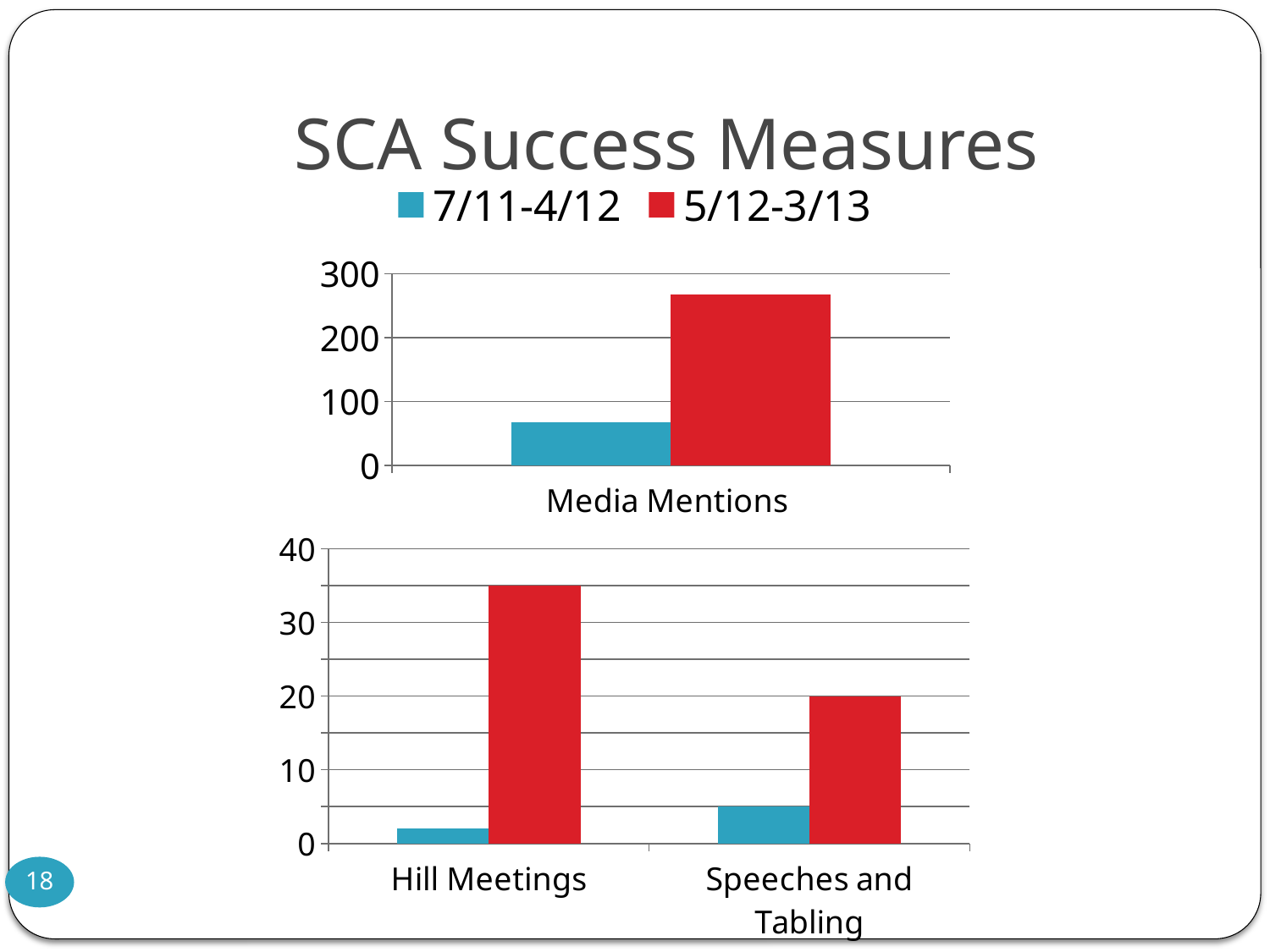
What kind of chart is the top chart (Media Mentions)? bar chart Which series is shown in red? 5/12-3/13 In the top chart, is the 7/11-4/12 value for Media Mentions greater or less than 100? less In the bottom chart, is the 7/11-4/12 value for Hill Meetings greater or less than 10? less In the bottom chart, is the 5/12-3/13 value for Hill Meetings greater or less than 30? greater What are the two series named in the legend? 7/11-4/12 and 5/12-3/13 In the bottom chart, how many categories are shown on the x axis? 2 In the top chart, which period has the larger value for Media Mentions, 7/11-4/12 or 5/12-3/13? 5/12-3/13 In the bottom chart, which category has the higher 5/12-3/13 value? Hill Meetings How many series does the legend list? 2